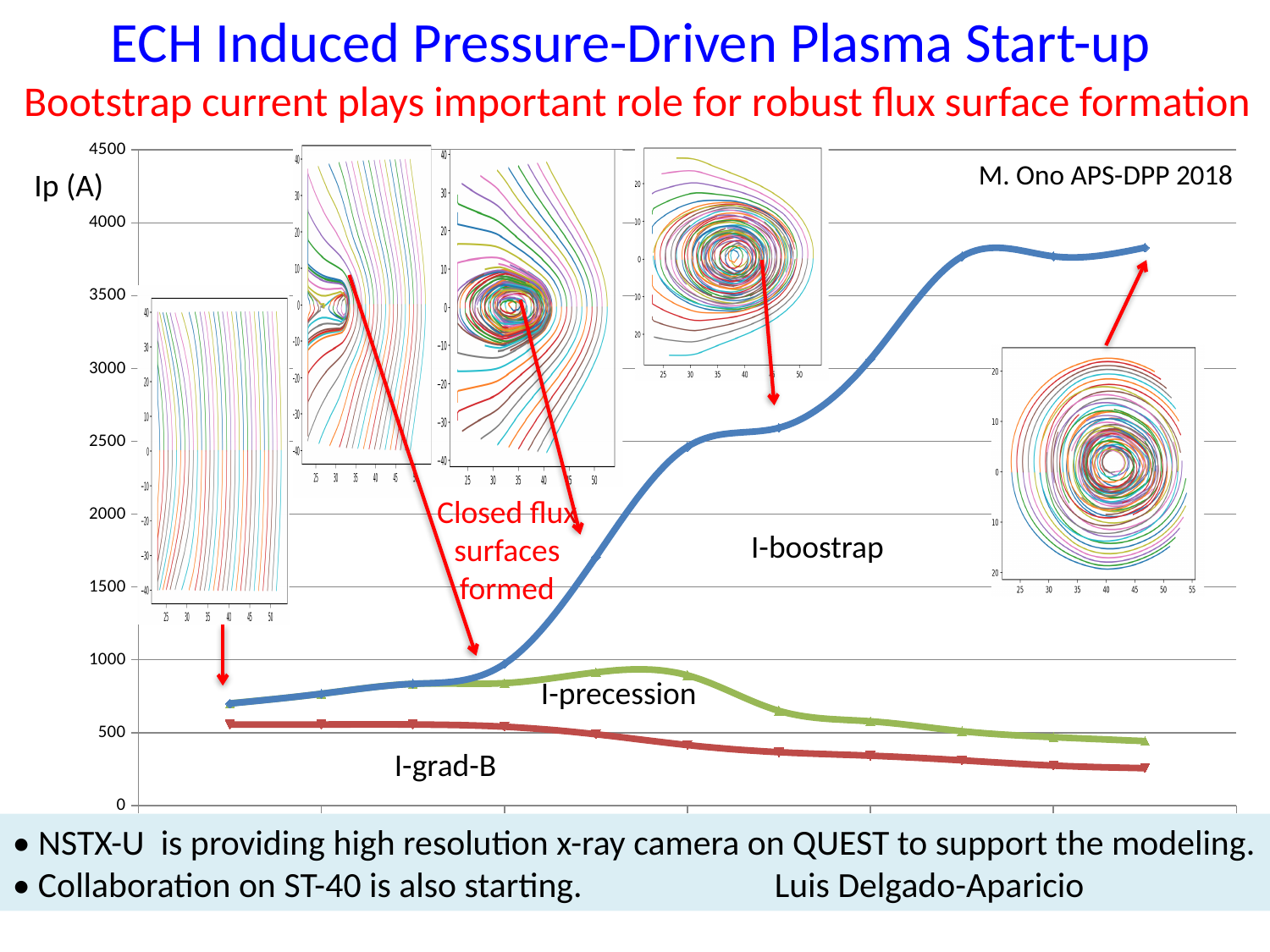
What is the label on the vertical axis of the chart? Ip (A) Does the I-grad-B series rise or fall along the x axis? fall Which series has the lowest value at the right end of the chart? I-grad-B What kind of chart is shown on the slide? line chart What is the highest value shown on the vertical axis? 4500 Is the final value of the I-boostrap series greater or less than 3500? greater Does the I-boostrap series rise or fall along the x axis? rise Which series reaches the highest value on the chart? I-boostrap At the right end of the chart, which is larger: I-boostrap or I-grad-B? I-boostrap How many current series are plotted on the chart? 3 Is the peak value of the I-precession series greater or less than 1000? less Is the starting value of the I-boostrap series greater or less than 1000? less